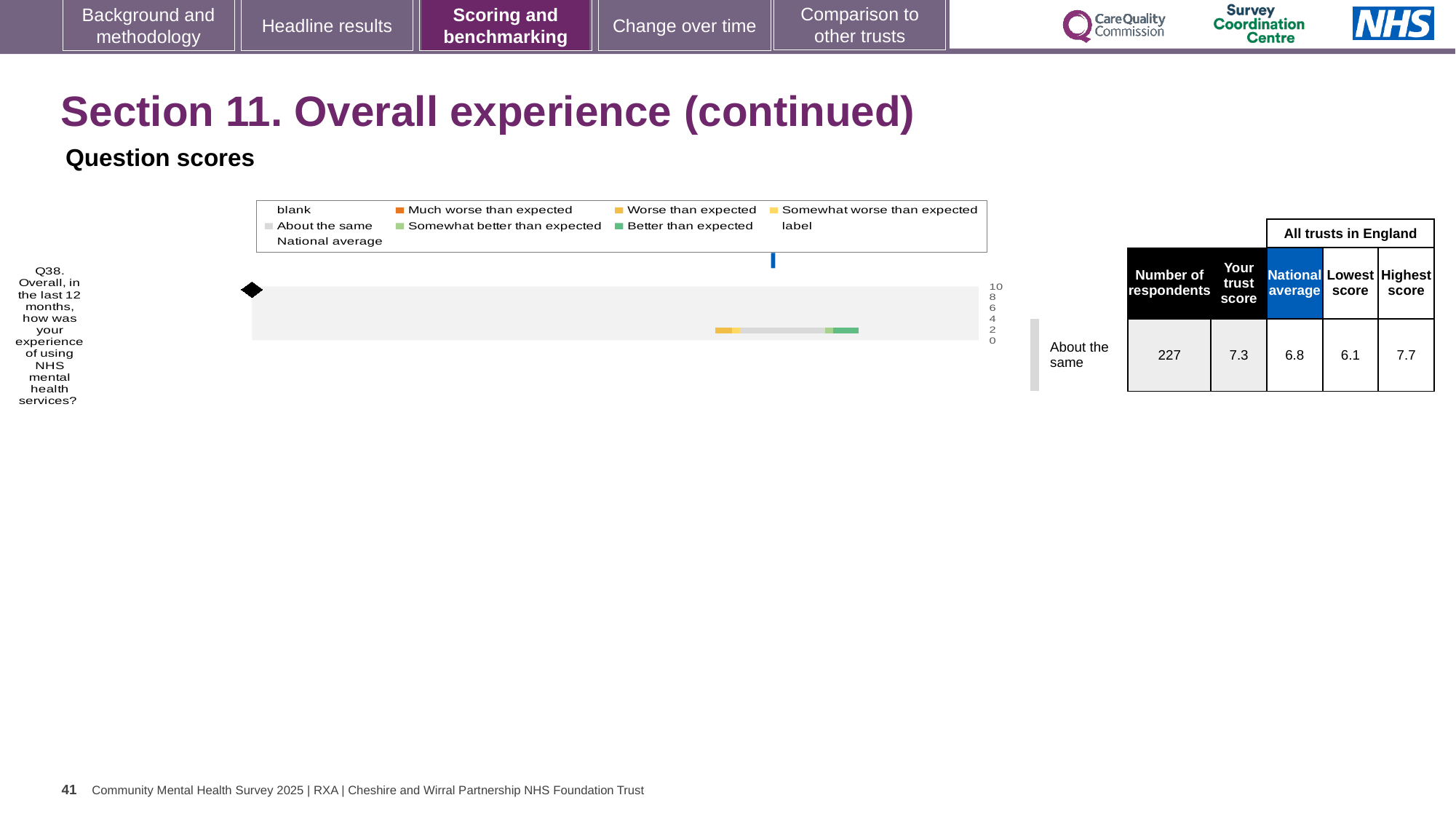
What is the difference between the highest and lowest scores for Q38 across all trusts in England? 1.6 How many survey questions are plotted in the chart? 1 What is the highest score among all trusts in England for Q38? 7.7 What is the national average score for Q38? 6.8 What benchmarking category is shown next to the Q38 bar? About the same How many respondents answered Q38? 227 Which is larger for Q38, the trust score or the national average? the trust score What is the lowest score among all trusts in England for Q38? 6.1 What is the trust score for Q38 (Overall, in the last 12 months, how was your experience of using NHS mental health services?)? 7.3 What kind of chart is used to show the Q38 question score? bar chart What is the maximum value shown on the chart's score axis? 10 By how much does the trust score for Q38 exceed the national average? 0.5